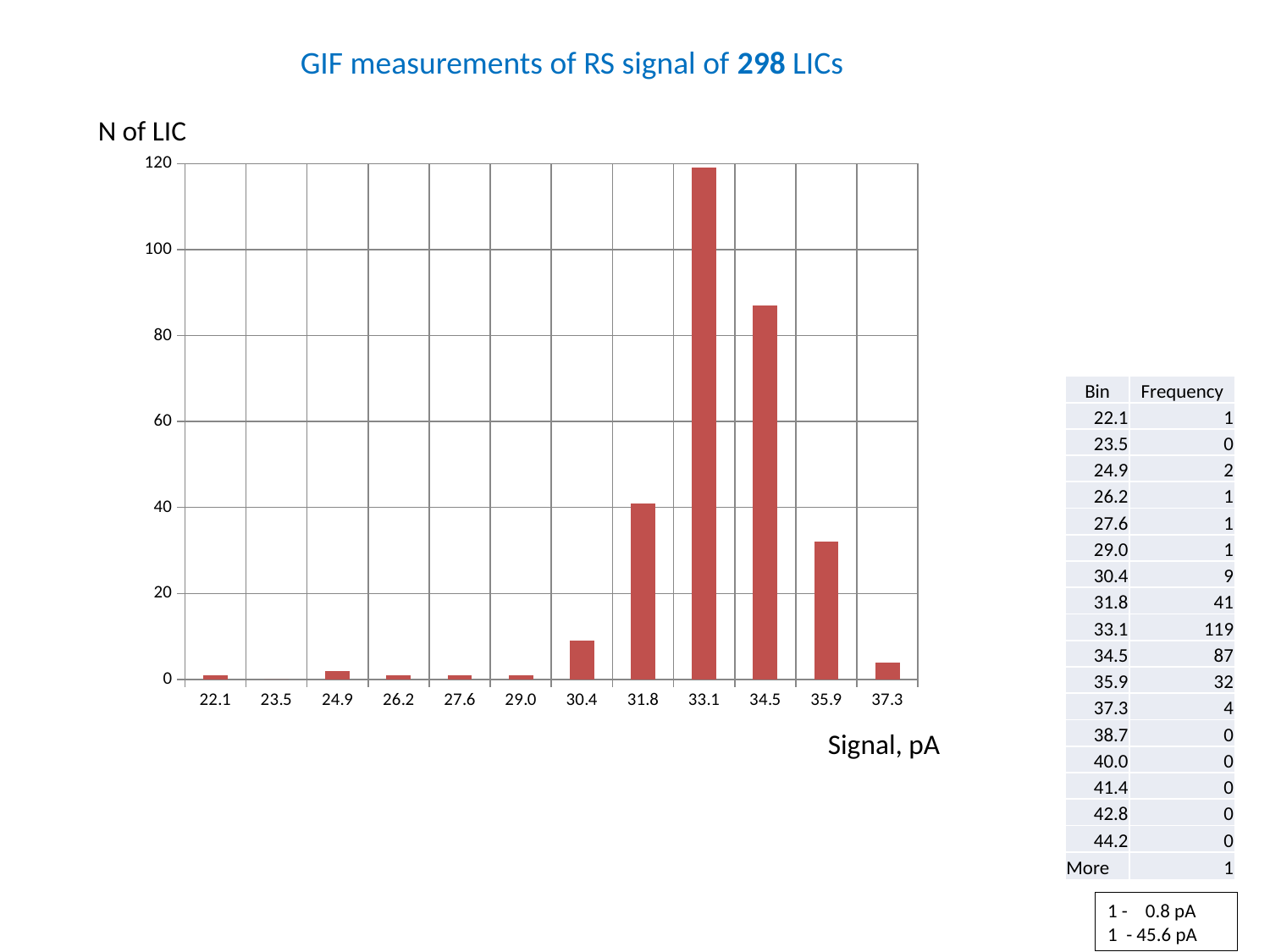
According to the table, what is the frequency for bin 33.1? 119 What kind of chart is shown on the slide? bar chart According to the table, what is the frequency for bin 34.5? 87 Which bin has more LICs, 31.8 or 35.9? 31.8 What is the difference between the frequencies of bins 33.1 and 34.5? 32 How many bins are shown on the x axis of the chart? 12 Is the value for bin 34.5 greater or less than 80? greater According to the table, what is the frequency for bin 31.8? 41 What is the label of the x axis? Signal, pA What is the label of the y axis? N of LIC Is the value for bin 35.9 greater or less than 40? less Which bin has the highest number of LICs? 33.1